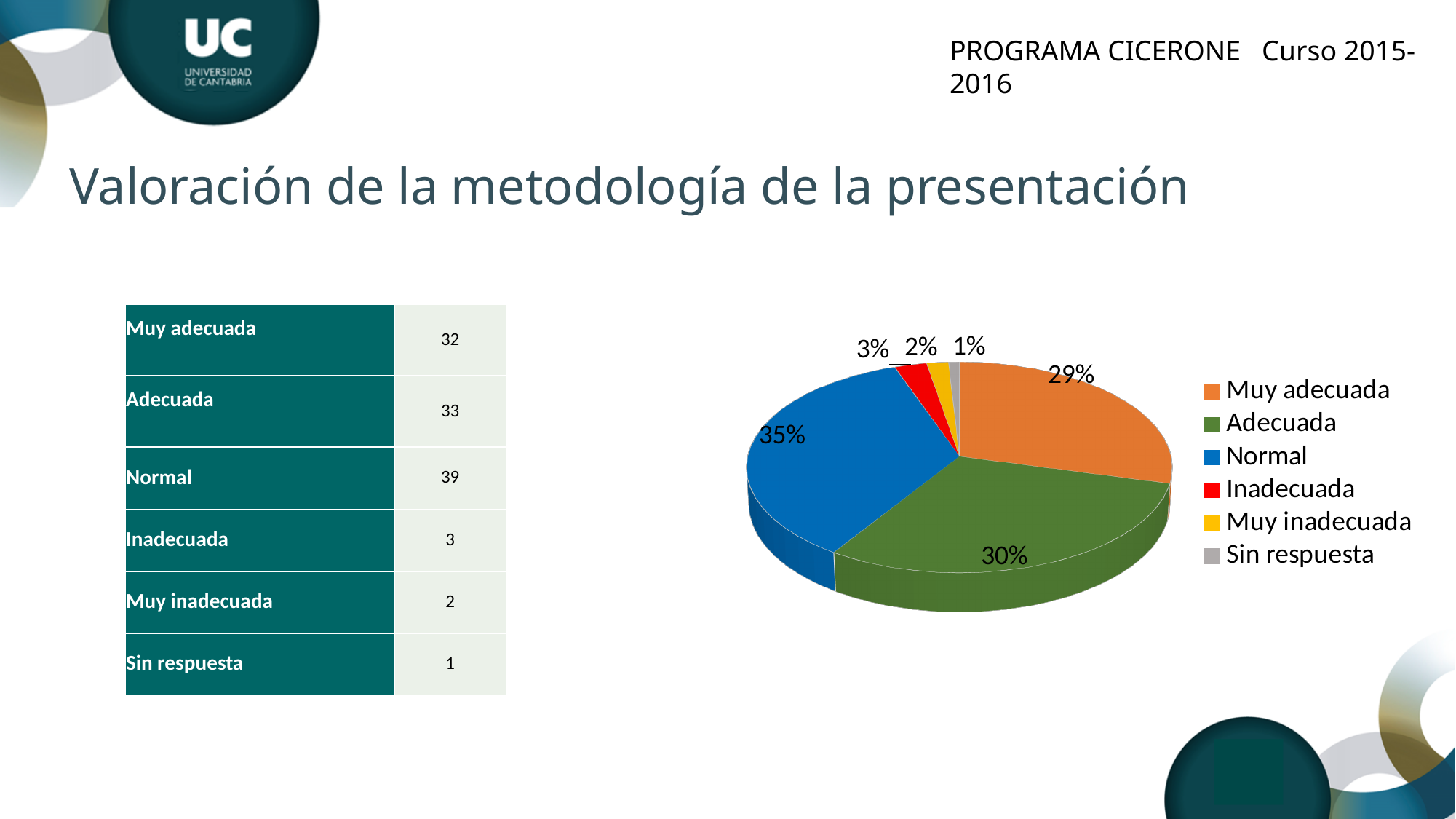
What percentage of the pie chart does the Sin respuesta slice represent? 1% What percentage of the pie chart does the Normal slice represent? 35% Which category has the smallest slice in the pie chart? Sin respuesta Which slice is larger in the pie chart, Inadecuada or Muy inadecuada? Inadecuada What percentage of the pie chart does the Muy adecuada slice represent? 29% Which category has the largest slice in the pie chart? Normal What kind of chart is shown on the slide? pie chart How many categories does the pie chart legend list? 6 What percentage of the pie chart does the Adecuada slice represent? 30% What colour is the Normal slice in the pie chart? blue What is the difference in percentage points between the Normal slice and the Muy adecuada slice? 6 What percentage of the pie chart does the Inadecuada slice represent? 3%